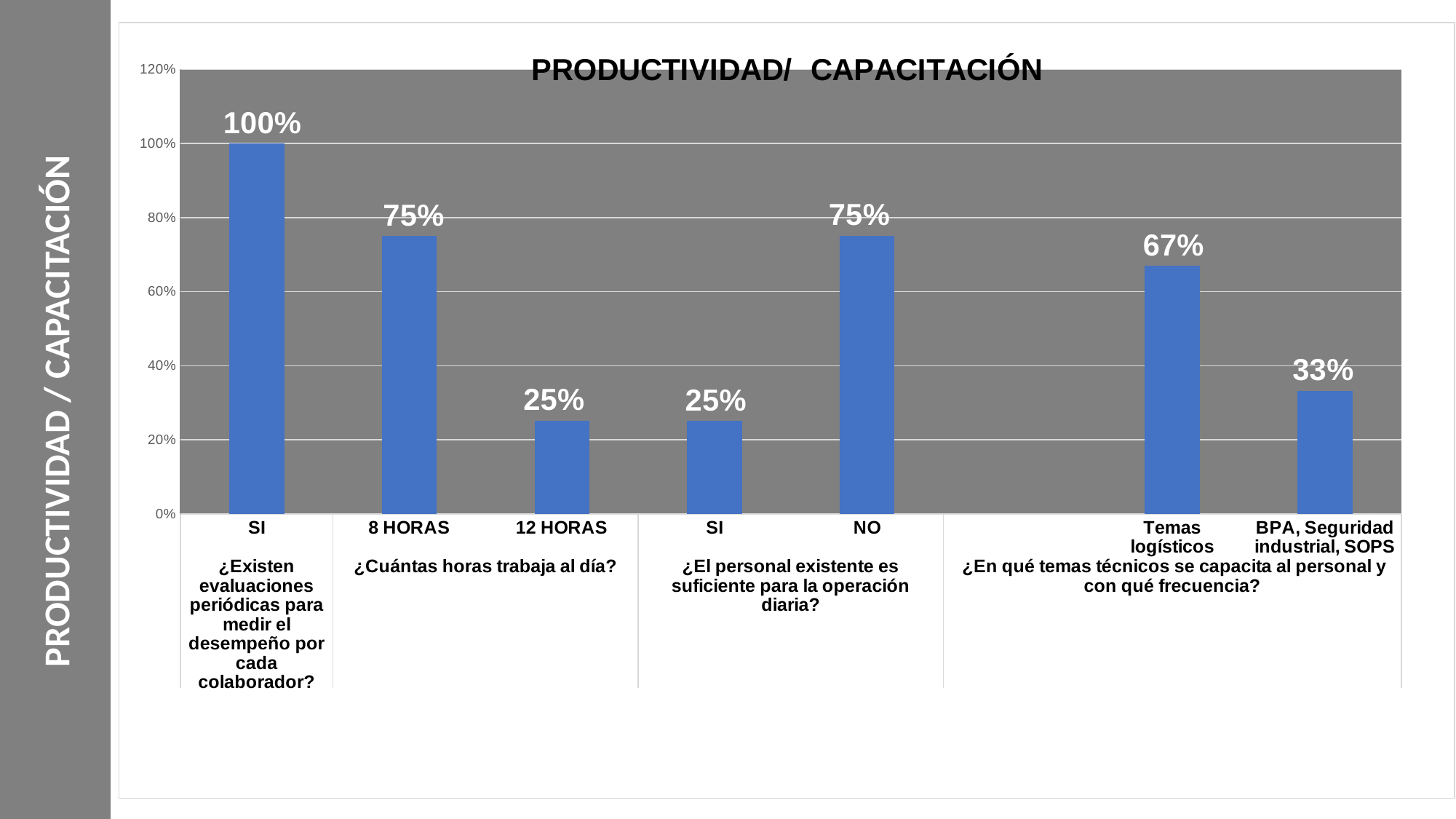
How many bars are plotted in the chart? 7 Which bar has the highest value in the chart? SI (¿Existen evaluaciones periódicas para medir el desempeño por cada colaborador?) What is the value for 'NO' under '¿El personal existente es suficiente para la operación diaria?'? 75% What is the value for 'Temas logísticos'? 67% What is the difference between the values for '8 HORAS' and '12 HORAS'? 50% What is the value for '8 HORAS' under '¿Cuántas horas trabaja al día?'? 75% Which is larger: the value for 'SI' or 'NO' under '¿El personal existente es suficiente para la operación diaria?'? NO What is the value for 'BPA, Seguridad industrial, SOPS'? 33% What is the title of the chart? PRODUCTIVIDAD/ CAPACITACIÓN What kind of chart is shown on the slide? Bar chart Is the value for 'Temas logísticos' greater or less than 60%? greater What is the difference between the values for 'Temas logísticos' and 'BPA, Seguridad industrial, SOPS'? 34%